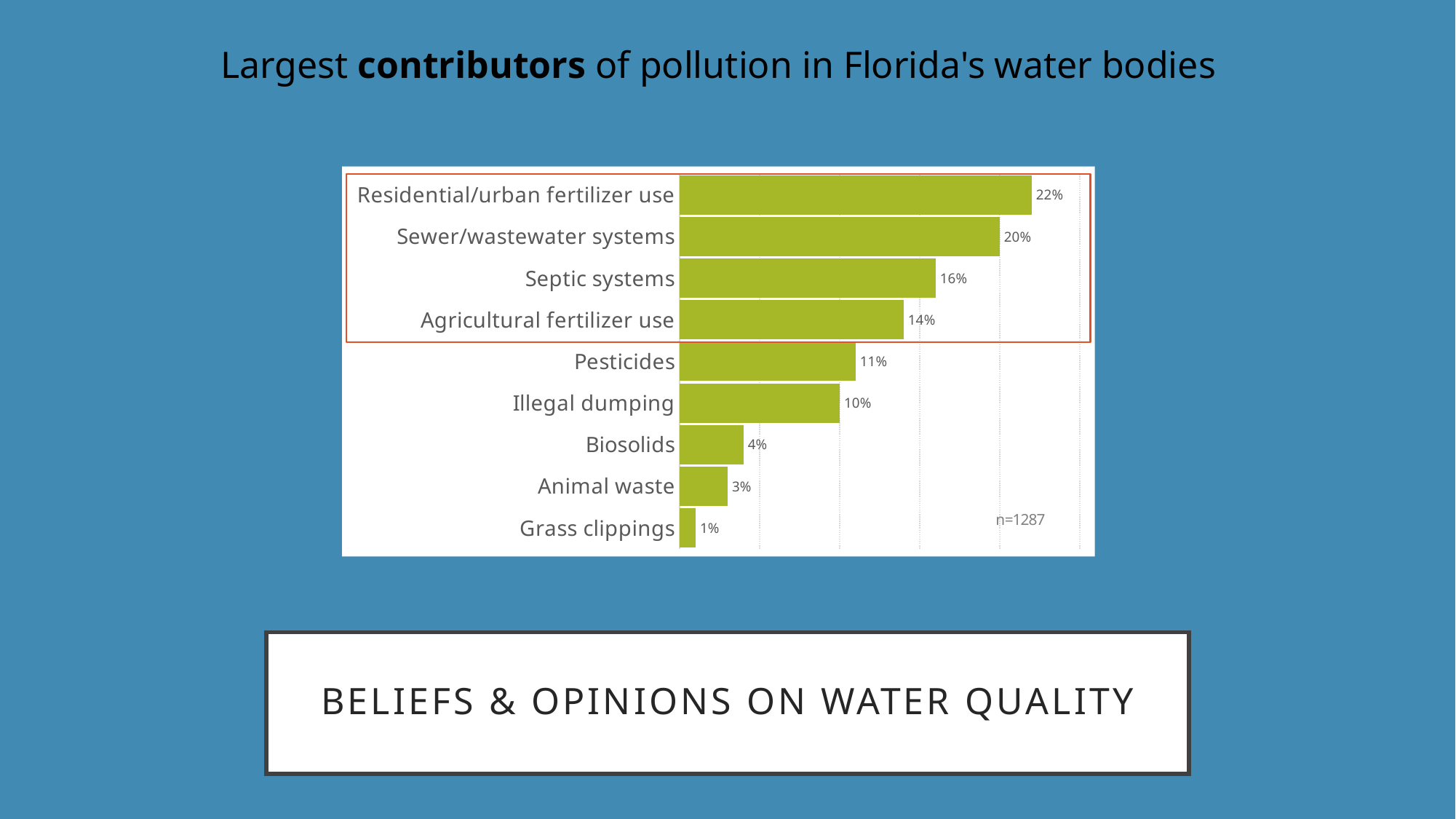
Which is larger, Septic systems or Pesticides? Septic systems Which is larger, Animal waste or Biosolids? Biosolids Which category has the highest value? Residential/urban fertilizer use What value is shown for Septic systems? 16% Which category has the lowest value? Grass clippings What sample size (n) is noted on the chart? n=1287 What is the difference between Sewer/wastewater systems and Agricultural fertilizer use? 6% What percentage is shown for Residential/urban fertilizer use? 22% What is the difference between Pesticides and Biosolids? 7% What percentage is shown for Illegal dumping? 10% How many categories are shown in the chart? 9 What kind of chart is shown on the slide? Bar chart